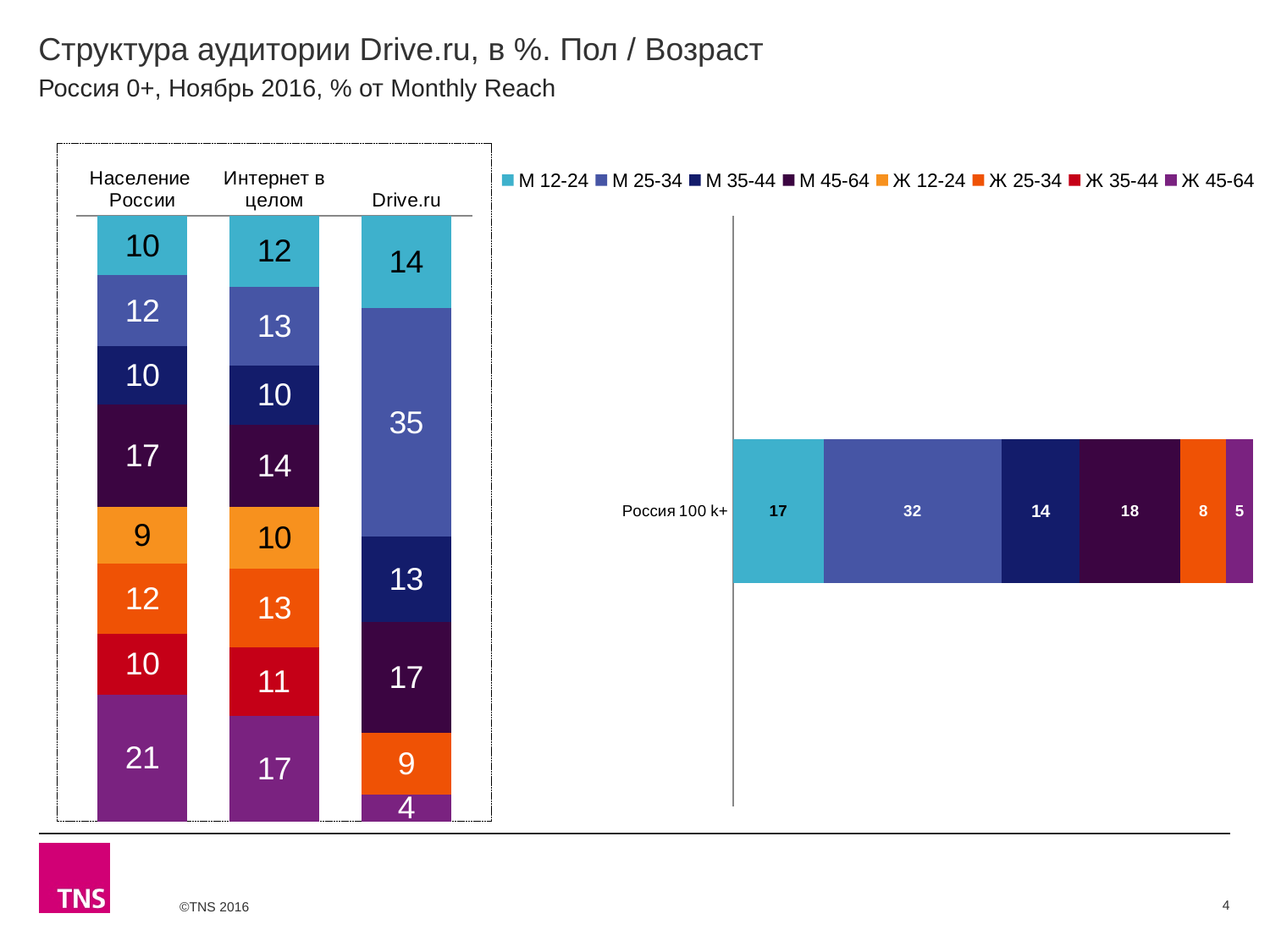
In the left chart, what is the value of the М 25-34 segment for Drive.ru? 35 How many columns (categories) are shown in the left chart? 3 What kind of chart is the right chart (Россия 100 k+)? Stacked bar chart In the left chart, which column has the largest М 25-34 segment? Drive.ru In the left chart, what is the value of the Ж 45-64 segment for Население России? 21 In the left chart, how much larger is the М 25-34 segment for Drive.ru than for Население России? 23 In the right chart (Россия 100 k+), what is the value of the Ж 45-64 segment? 5 In the left chart, which is larger: the Ж 45-64 segment for Население России or for Интернет в целом? Население России In the right chart (Россия 100 k+), which segment is the largest? М 25-34 In the right chart (Россия 100 k+), what is the value of the М 25-34 segment? 32 How many series does the legend list? 8 In the left chart, what is the value of the М 45-64 segment for Интернет в целом? 14